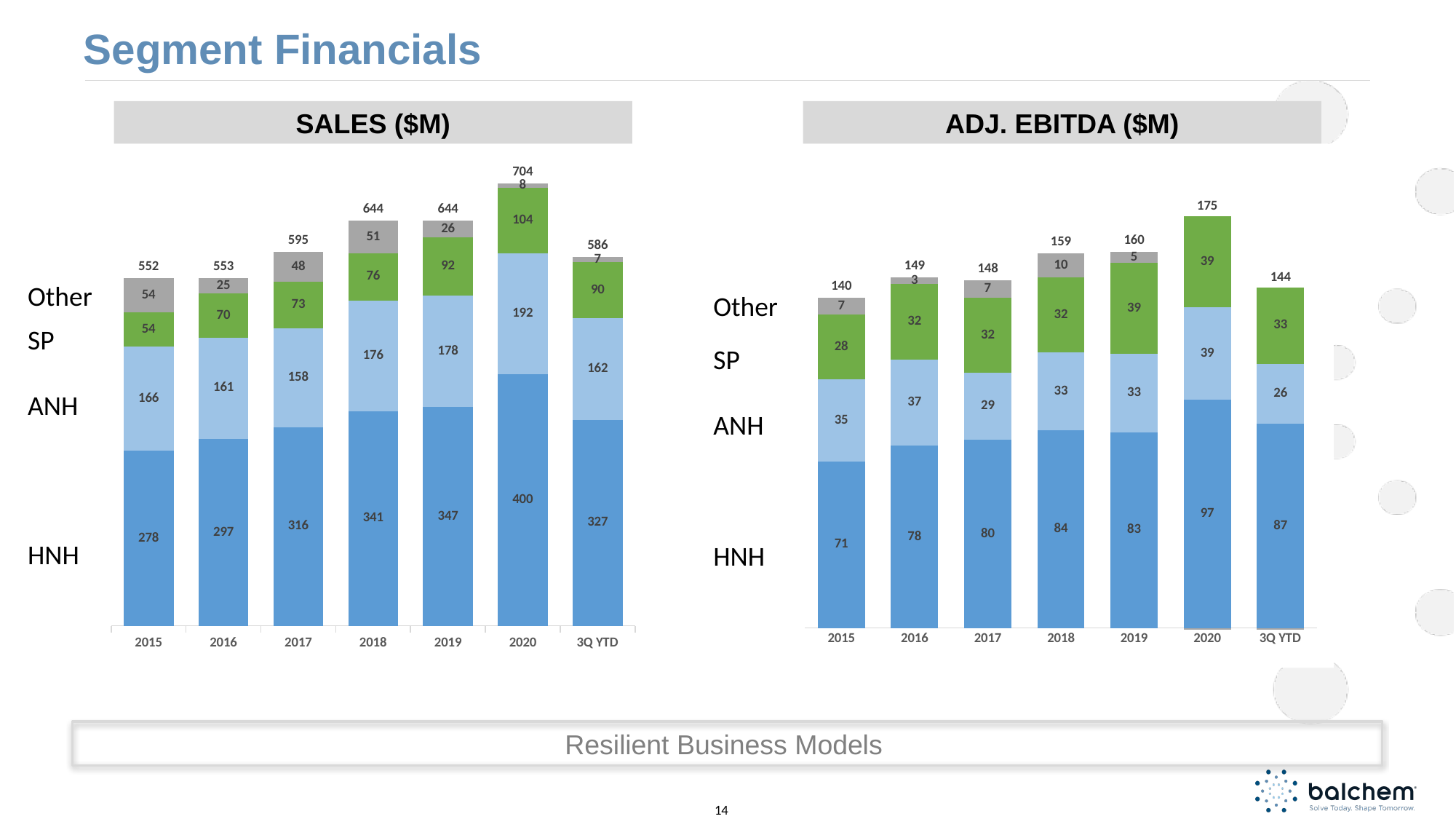
How many categories are shown on the x axis of the SALES ($M) chart? 7 How many segments (series) are labelled in the ADJ. EBITDA ($M) chart? 4 What kind of chart is the SALES ($M) chart? Stacked bar chart In the ADJ. EBITDA ($M) chart, what is the SP value for 2019? 39 In the ADJ. EBITDA ($M) chart, which category has the lowest total? 2015 In the SALES ($M) chart, do the HNH values rise or fall from 2015 to 2020? Rise In the SALES ($M) chart, which year has the highest total sales? 2020 In the ADJ. EBITDA ($M) chart, what is the total of the stacked bar for 3Q YTD? 144 In the SALES ($M) chart, what is the difference between the HNH values for 2020 and 2019? 53 In the SALES ($M) chart, what is the total of the stacked bar for 2018? 644 In the ADJ. EBITDA ($M) chart, which is larger, the ANH value for 2016 or the ANH value for 2017? 2016 In the SALES ($M) chart, what is the HNH value for 2020? 400